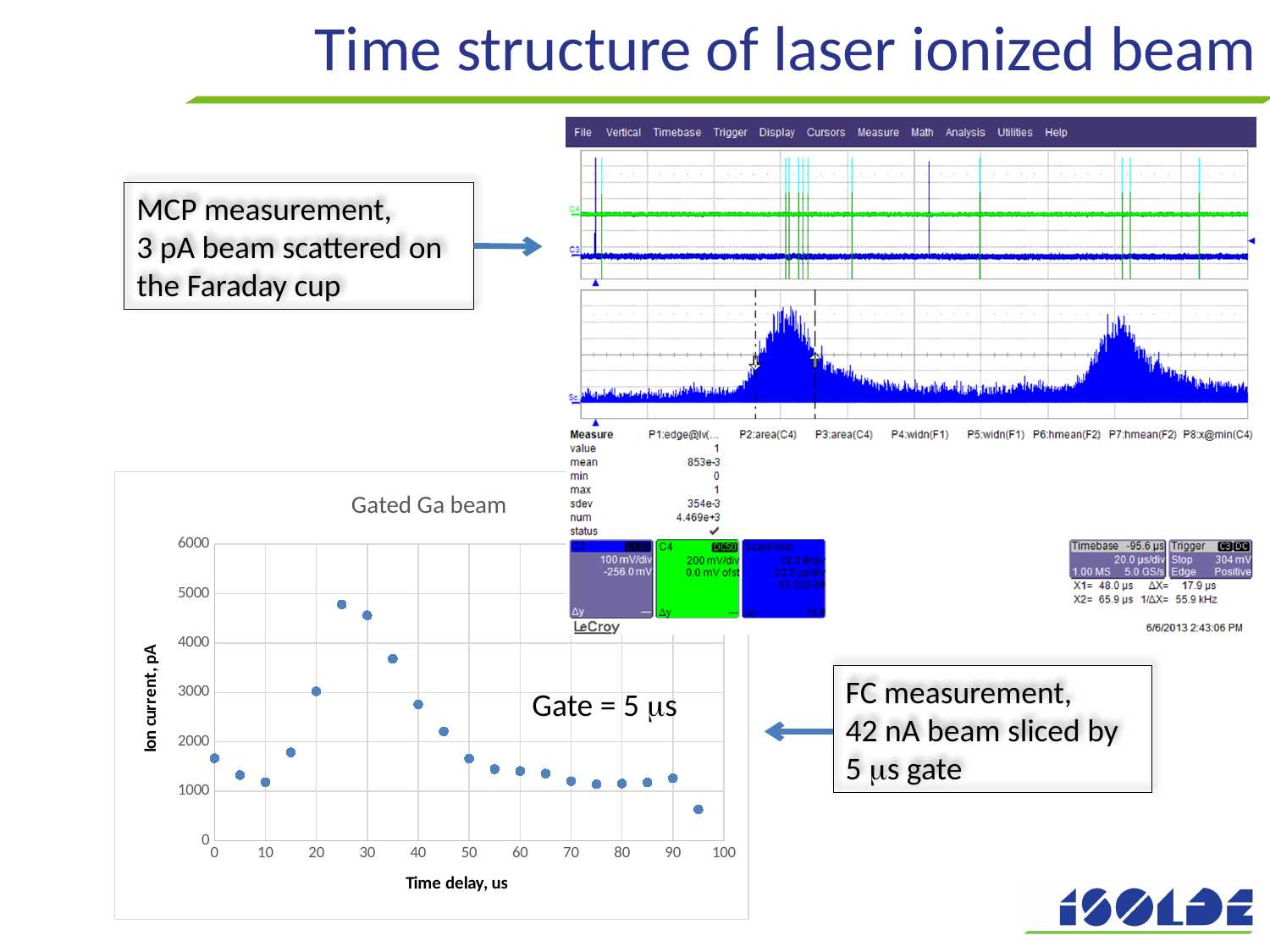
On the Gated Ga beam chart, is the ion current at a time delay of 20 us greater or less than 2000? greater On the Gated Ga beam chart, is the ion current at a time delay of 25 us greater or less than 4000? greater What is the label of the y axis on the Gated Ga beam chart? Ion current, pA How many data points are plotted on the Gated Ga beam chart? 20 On the Gated Ga beam chart, is the ion current at a time delay of 95 us greater or less than 1000? less What kind of chart is the Gated Ga beam chart? scatter chart On the Gated Ga beam chart, which has the larger ion current: a time delay of 35 us or 50 us? 35 us What is the title of the chart on the slide? Gated Ga beam On the Gated Ga beam chart, does the ion current rise or fall between time delays of 30 us and 50 us? fall At which time delay is the ion current highest on the Gated Ga beam chart? 25 At which time delay is the ion current lowest on the Gated Ga beam chart? 95